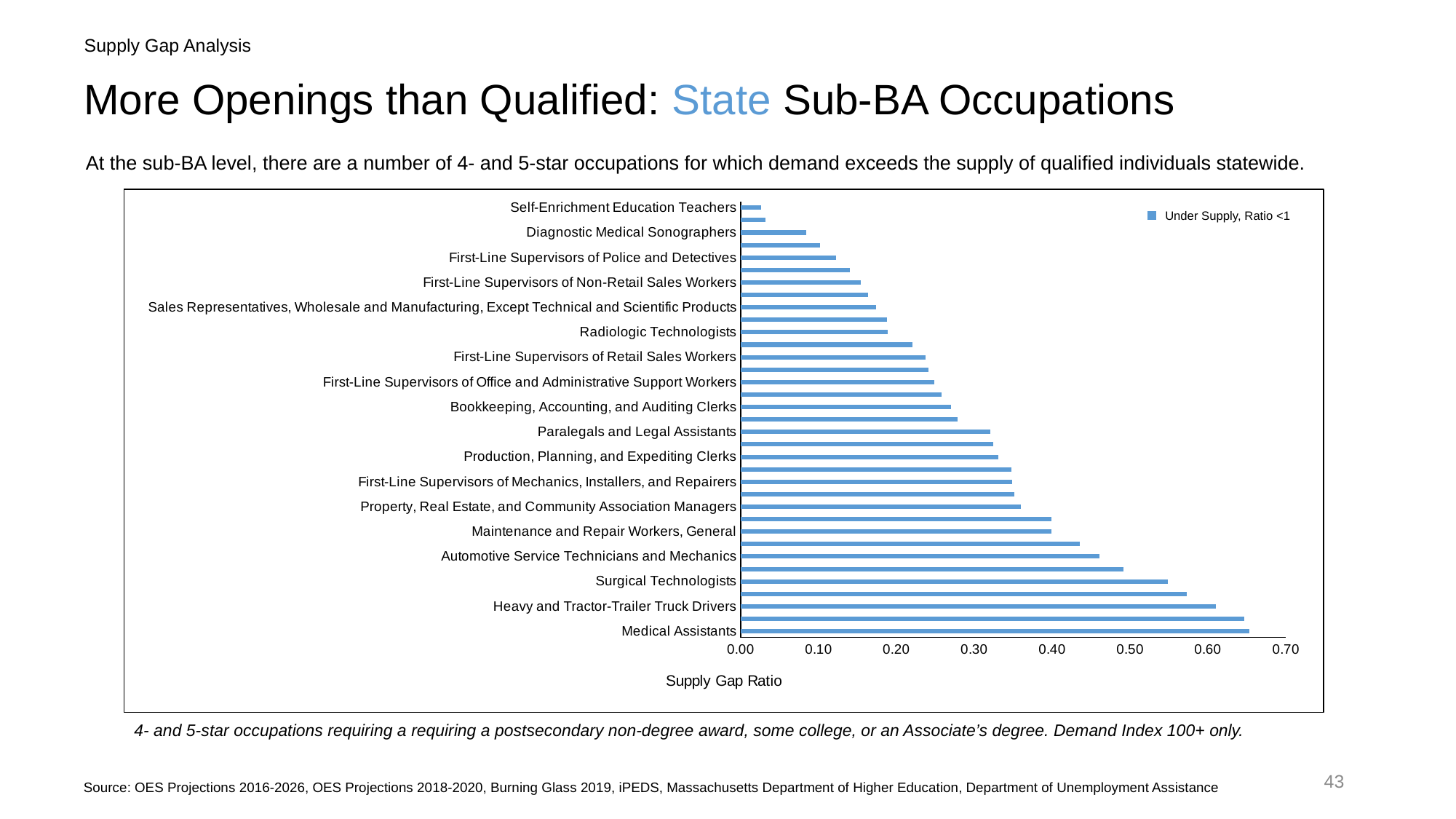
Is the Supply Gap Ratio for Medical Assistants greater or less than 0.60? greater Which has the larger Supply Gap Ratio, Surgical Technologists or Radiologic Technologists? Surgical Technologists Is the Supply Gap Ratio for Surgical Technologists greater or less than 0.50? greater Do the bars get longer or shorter moving from the top of the chart to the bottom? longer Is the Supply Gap Ratio for Bookkeeping, Accounting, and Auditing Clerks greater or less than 0.30? less Which labeled occupation has the shortest bar in the chart? Self-Enrichment Education Teachers What kind of chart is shown on the slide? bar chart How many series does the chart legend list? 1 What is the legend entry shown on the chart? Under Supply, Ratio <1 What is the title of the horizontal axis of the chart? Supply Gap Ratio